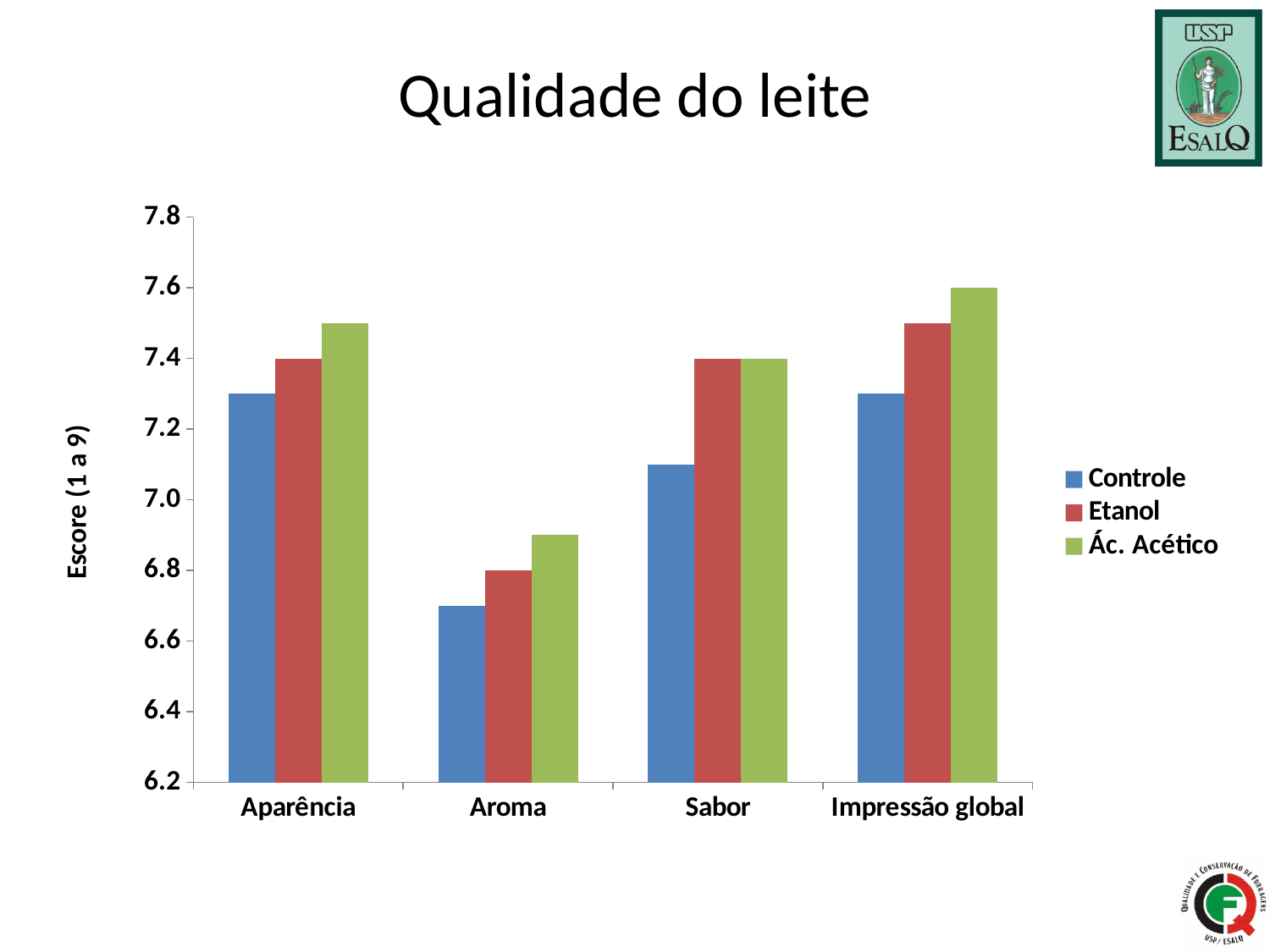
For which category is the Controle score lowest? Aroma Is the Controle value for Sabor greater or less than 7.2? less How many series does the legend list? 3 What kind of chart is shown on the slide? bar chart How many categories are shown on the x axis? 4 For which category is the Ác. Acético score highest? Impressão global Is the Controle value for Aroma greater or less than 6.8? less Is the Ác. Acético value for Aparência greater or less than 7.4? greater For Aparência, which is larger: Controle or Etanol? Etanol For Impressão global, which is larger: Etanol or Ác. Acético? Ác. Acético What is the title of the y axis? Escore (1 a 9) What is the Ác. Acético score for Impressão global? 7.6